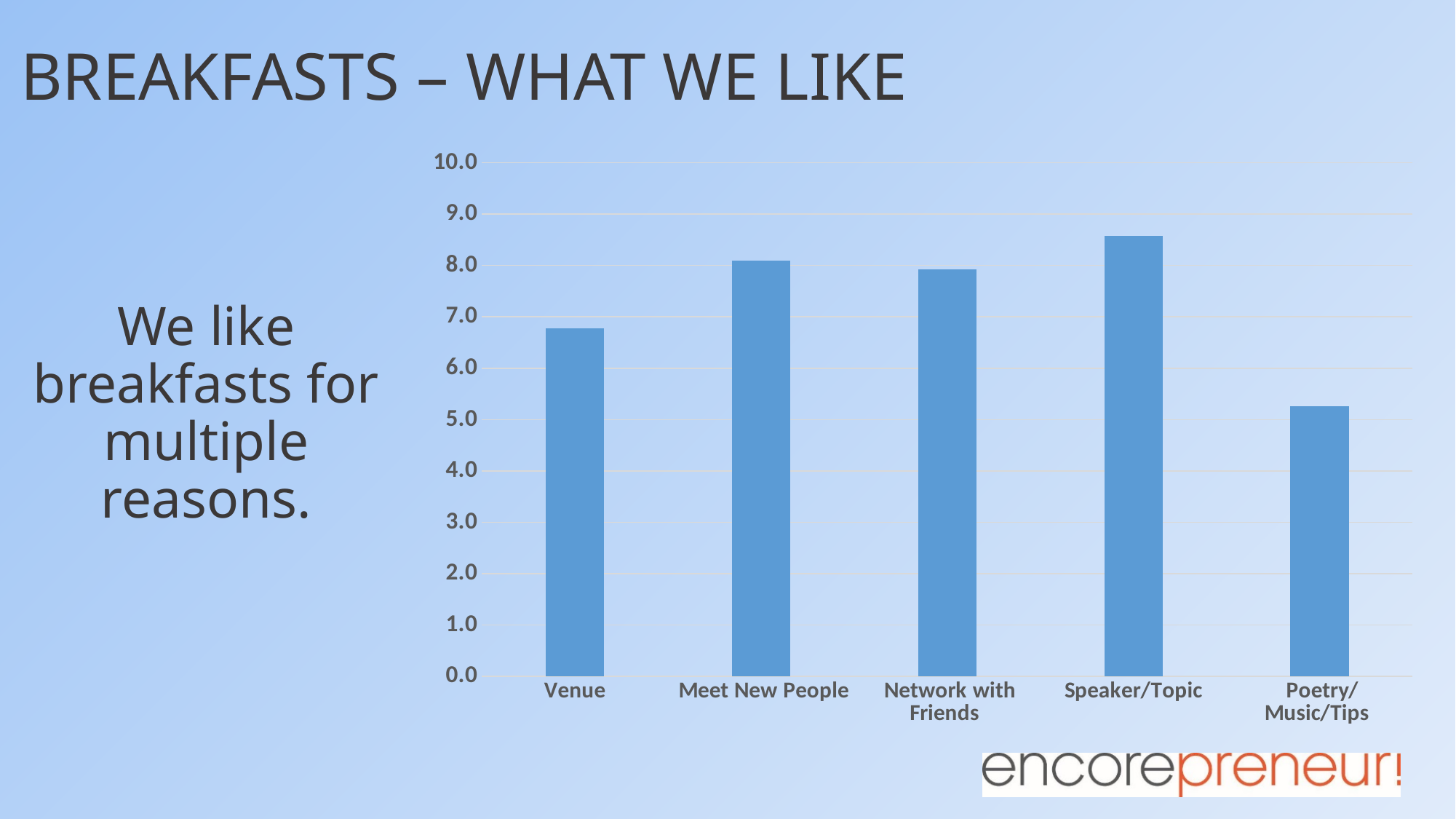
What kind of chart is shown on the slide? bar chart How many categories are shown on the x axis of the chart? 5 Is the value for Poetry/Music/Tips greater or less than 5.0? greater Which is larger, the value for Speaker/Topic or the value for Venue? Speaker/Topic Which is larger, the value for Venue or the value for Poetry/Music/Tips? Venue Is the value for Speaker/Topic greater or less than 8.0? greater Which category has the lowest bar in the chart? Poetry/Music/Tips Is the value for Venue greater or less than 7.0? less What is the maximum value shown on the chart's vertical axis? 10.0 Which category has the highest bar in the chart? Speaker/Topic